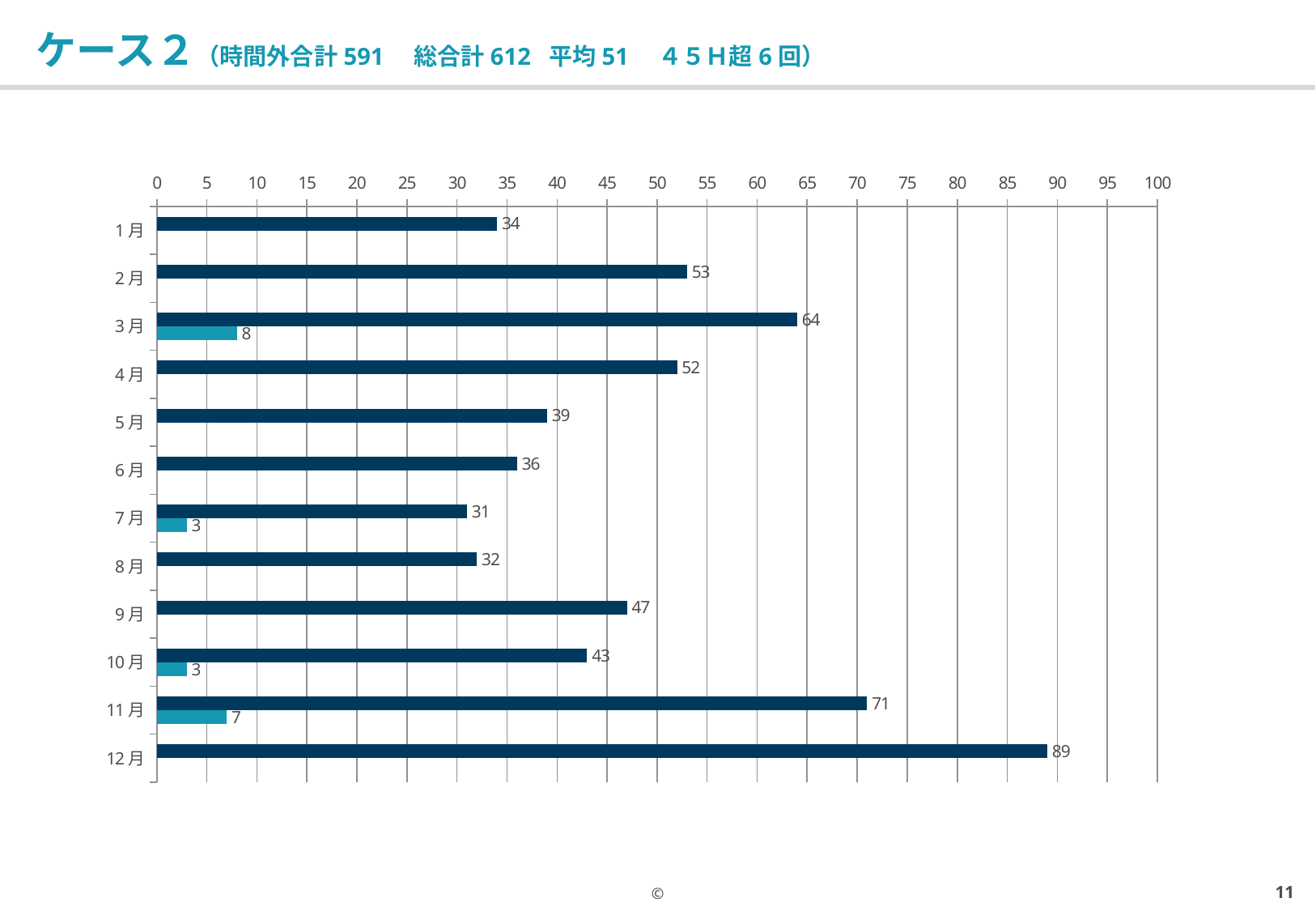
How many months have a light blue bar? 4 What is the value of the dark blue bar for 12月? 89 Which month has the highest dark blue bar? 12月 Which month has the lowest dark blue bar? 7月 Which month has the highest light blue bar? 3月 Is the dark blue value for 12月 greater or less than 80? greater What is the value of the light blue bar for 11月? 7 Which has the larger dark blue value, 2月 or 4月? 2月 What is the value of the dark blue bar for 3月? 64 How many months are shown on the chart? 12 What is the difference between the dark blue values for 12月 and 11月? 18 What kind of chart is shown on the slide? bar chart